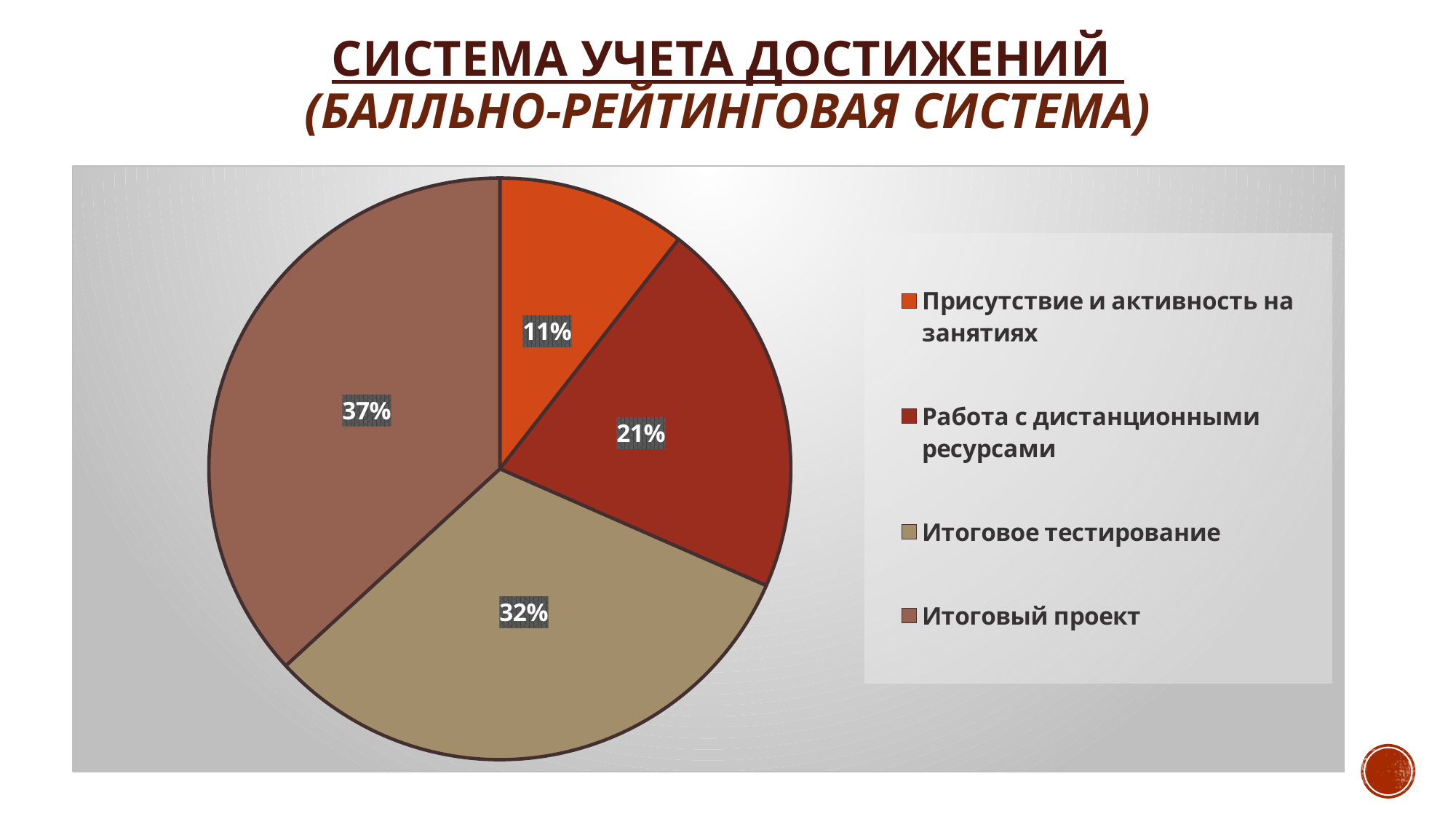
Which category has the largest slice of the pie? Итоговый проект What is the value for "Присутствие и активность на занятиях"? 11% Which is larger: the share for "Итоговое тестирование" or the share for "Работа с дистанционными ресурсами"? Итоговое тестирование What is the difference between the shares of "Итоговый проект" and "Итоговое тестирование"? 5% What share of the pie does "Итоговое тестирование" have? 32% What share of the pie does "Итоговый проект" have? 37% What kind of chart is shown on the slide? pie chart Which category has the smallest slice of the pie? Присутствие и активность на занятиях How many categories does the pie chart have? 4 What is the value for "Работа с дистанционными ресурсами"? 21% What is the difference between the shares of "Работа с дистанционными ресурсами" and "Присутствие и активность на занятиях"? 10% Which category is shown in the orange colour in the legend? Присутствие и активность на занятиях